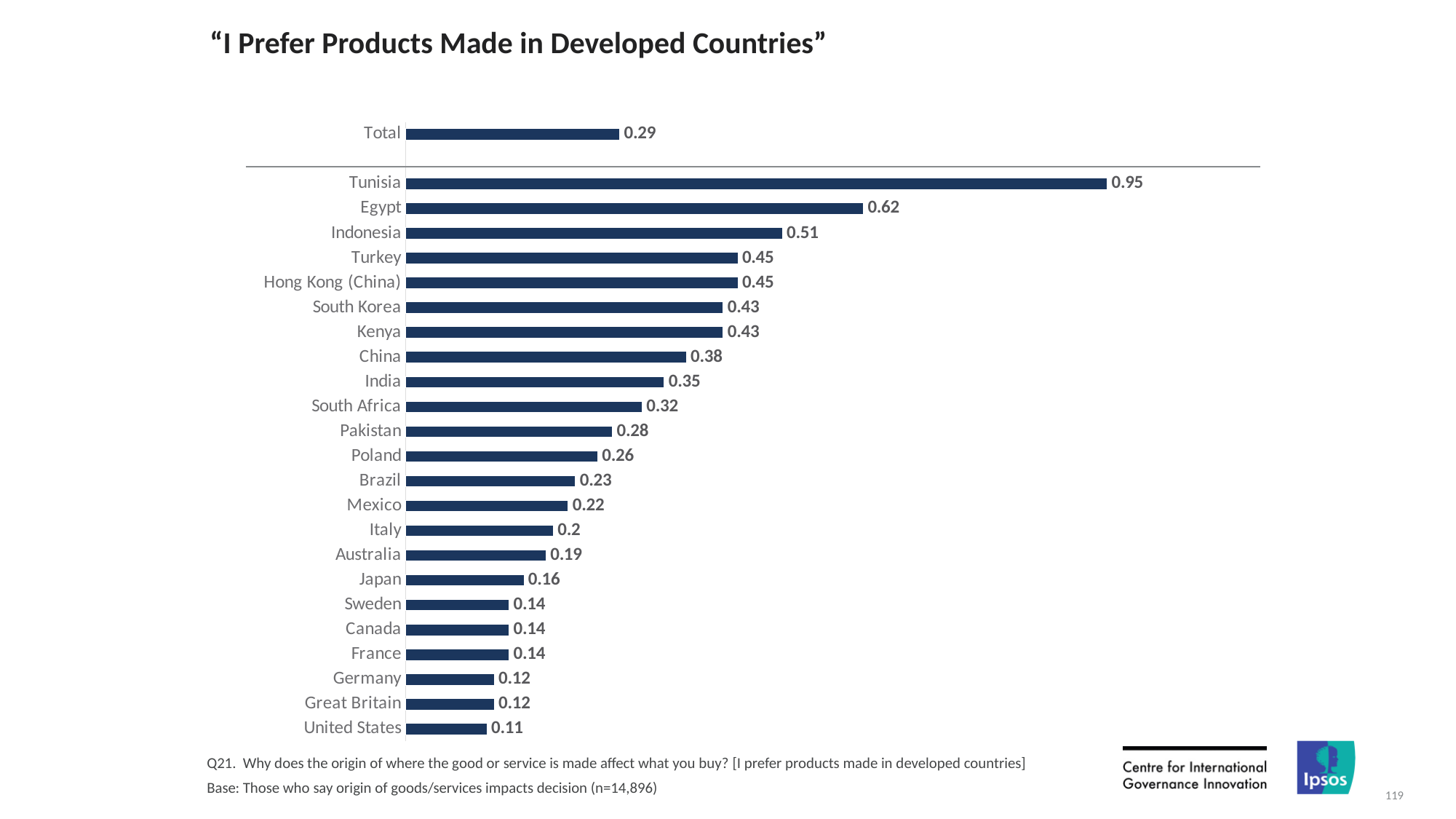
What is the value for Japan? 0.16 Which country has the highest value? Tunisia What is the difference between the values for Tunisia and Egypt? 0.33 What is the title of the chart? "I Prefer Products Made in Developed Countries" How many countries are listed below the Total bar? 23 What is the value for Tunisia? 0.95 Which has a larger value, Brazil or Australia? Brazil What kind of chart is shown on the slide? Bar chart Which country has the lowest value? United States What is the difference between the values for China and India? 0.03 Which has a larger value, Indonesia or South Korea? Indonesia What is the value for Total? 0.29